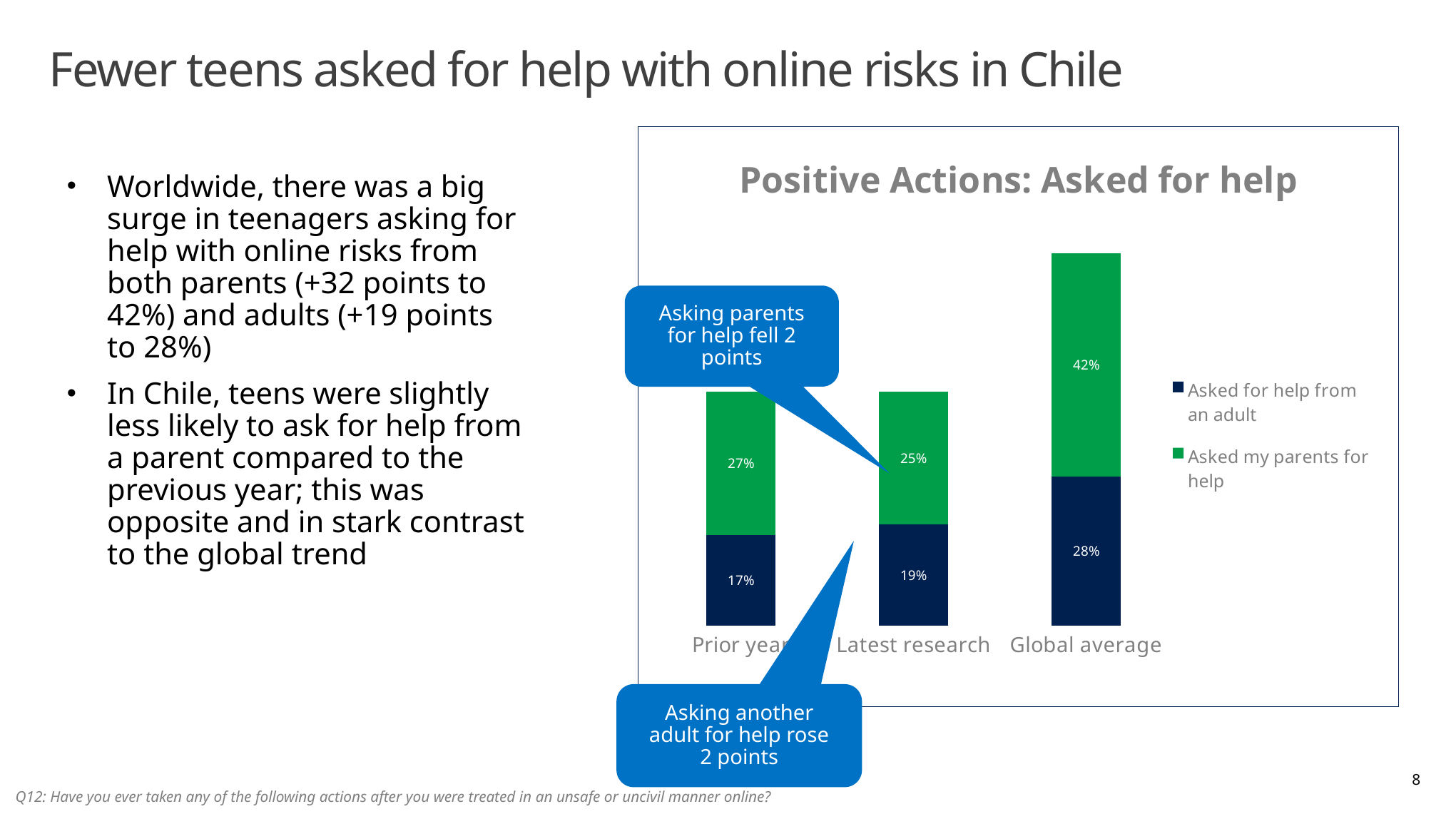
How many categories are shown on the x axis? 3 What is the value for 'Asked for help from an adult' in the Latest research? 19% Which category has the highest value for 'Asked my parents for help'? Global average What is the Global average value for 'Asked for help from an adult'? 28% What is the value for 'Asked my parents for help' in the Prior year? 27% Which is larger: 'Asked for help from an adult' in the Latest research or in the Prior year? Latest research What is the Global average value for 'Asked my parents for help'? 42% How many series does the legend list? 2 What kind of chart is shown on the slide? Stacked bar chart What is the total of the stacked bar for Global average? 70% Which category has the lowest value for 'Asked for help from an adult'? Prior year What is the difference between the 'Asked my parents for help' values for Prior year and Latest research? 2 percentage points